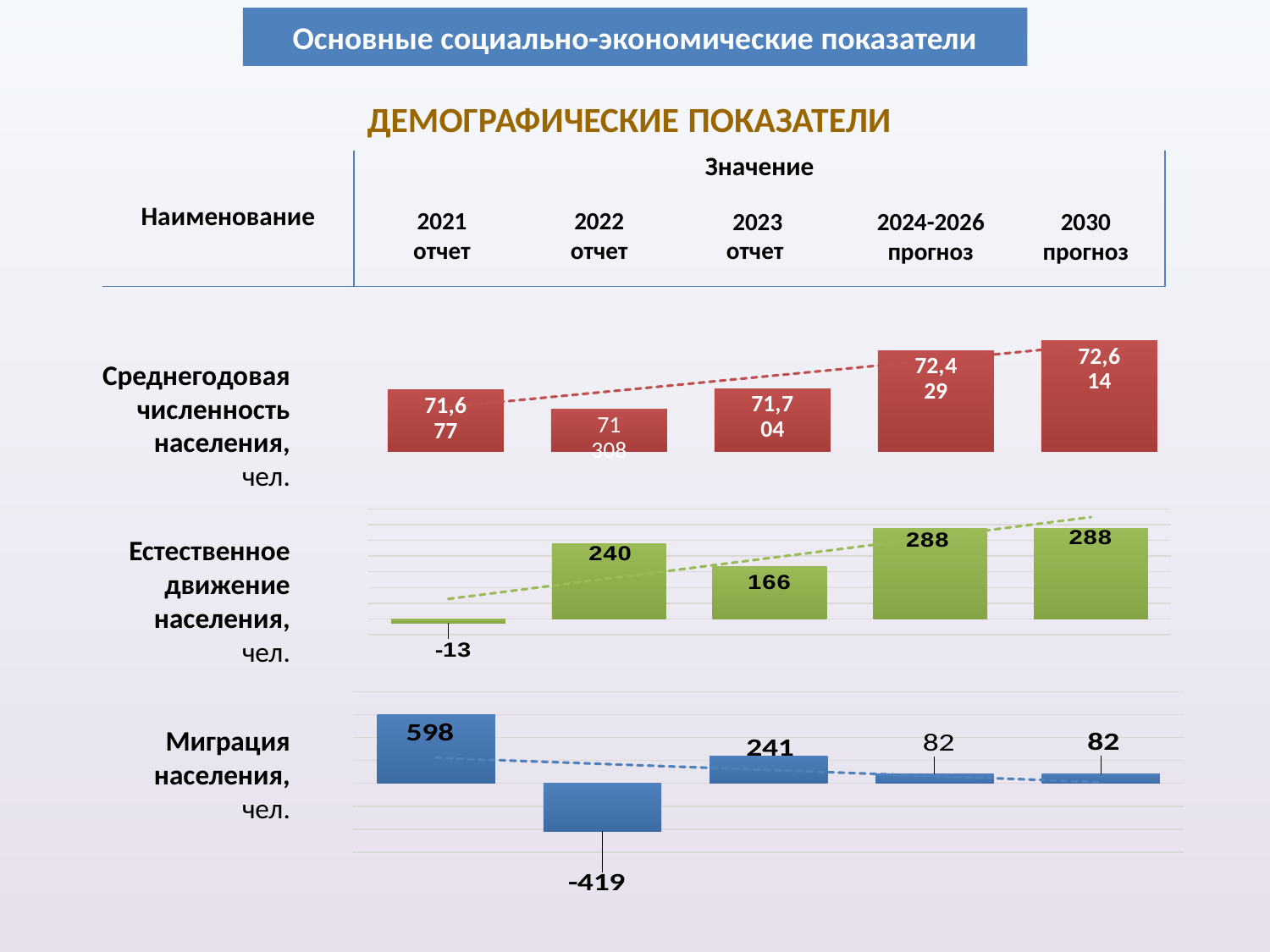
On the 'Естественное движение населения' chart, what is the difference between the 2022 отчет and 2023 отчет values? 74 On the 'Среднегодовая численность населения' chart, which period has the highest value? 2030 прогноз On the 'Миграция населения' chart, what is the difference between the 2021 отчет and 2023 отчет values? 357 On the 'Миграция населения' chart, what is the value for 2021 отчет? 598 On the 'Естественное движение населения' chart, what is the value for 2022 отчет? 240 On the 'Миграция населения' chart, which period has the lowest value? 2022 отчет What type of chart is used for 'Миграция населения'? bar chart On the 'Естественное движение населения' chart, which period has the lowest value? 2021 отчет On the 'Естественное движение населения' chart, what is the value for 2021 отчет? -13 On the 'Среднегодовая численность населения' chart, which period has the lowest value? 2022 отчет On the 'Миграция населения' chart, which period has the highest value? 2021 отчет On the 'Миграция населения' chart, what is the value for 2022 отчет? -419